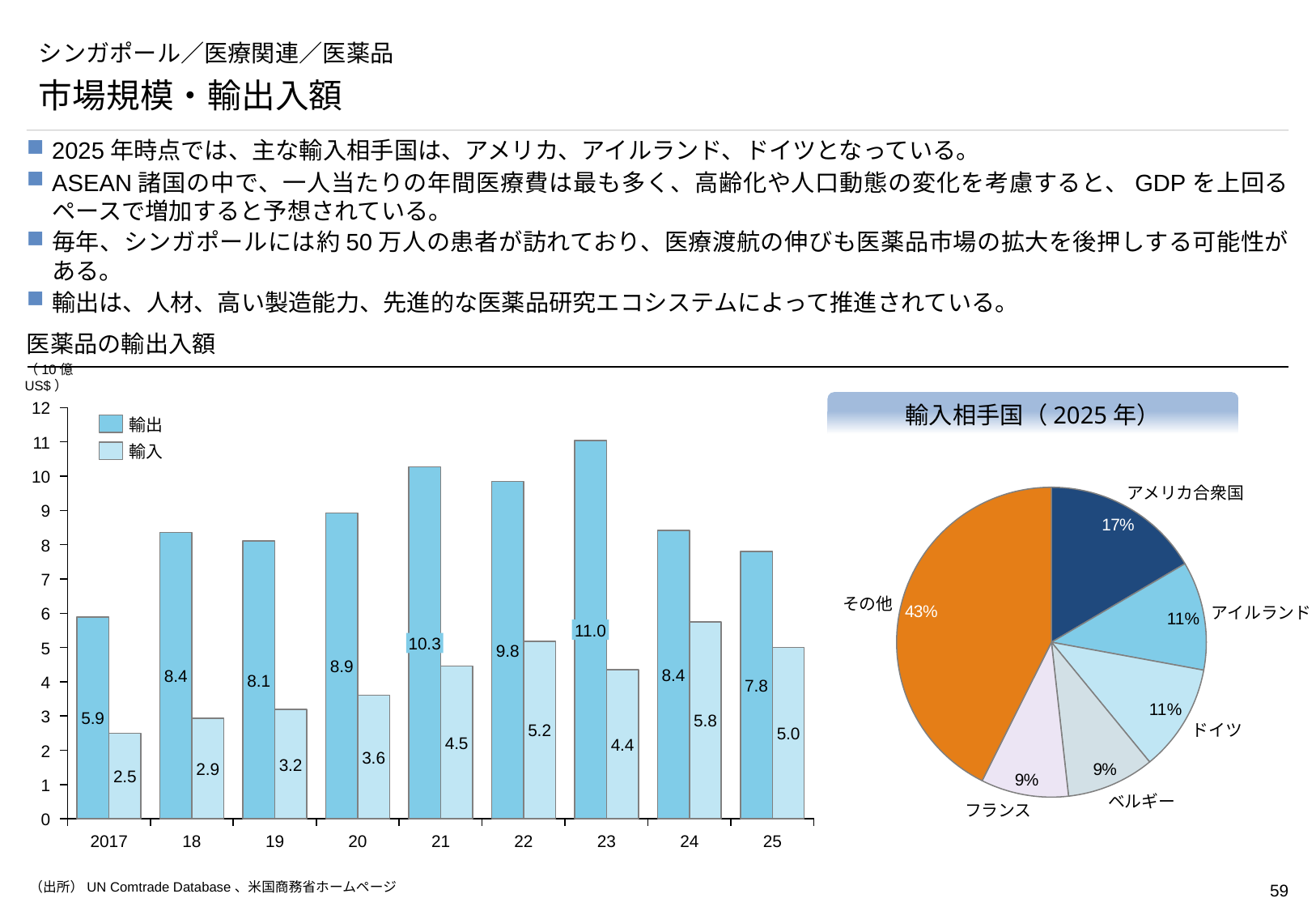
In the bar chart 医薬品の輸出入額, which year has the highest 輸出 value? 23 In the bar chart 医薬品の輸出入額, how many years are shown on the x axis? 9 In the pie chart 輸入相手国（2025年）, which slice is the largest? その他 In the bar chart 医薬品の輸出入額, what is the 輸出 value for 2017? 5.9 In the bar chart 医薬品の輸出入額, what is the difference between the 輸出 and 輸入 values for 21? 5.8 In the bar chart 医薬品の輸出入額, which year has the lowest 輸入 value? 2017 In the bar chart 医薬品の輸出入額, what is the 輸入 value for 24? 5.8 In the pie chart 輸入相手国（2025年）, how many slices are there? 6 In the bar chart 医薬品の輸出入額, how many series does the legend list? 2 In the bar chart 医薬品の輸出入額, which is larger, the 輸入 value for 22 or the 輸入 value for 23? 22 In the pie chart 輸入相手国（2025年）, what share does アメリカ合衆国 have? 17% What kind of chart is 医薬品の輸出入額? bar chart